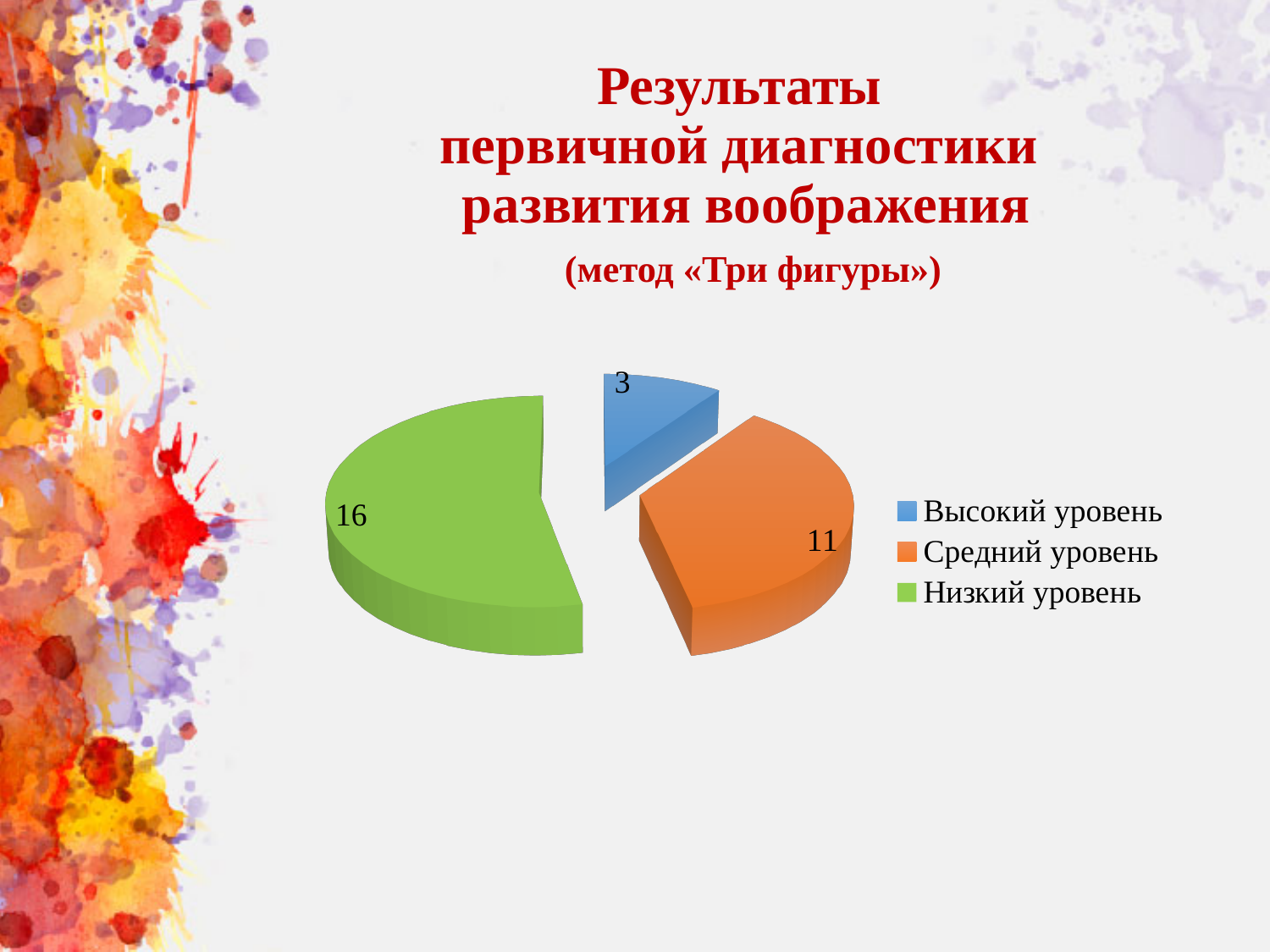
Which level has the largest slice of the pie? Низкий уровень Which is larger, the value for Средний уровень or the value for Высокий уровень? Средний уровень What kind of chart is shown on the slide? pie chart What value is shown for Средний уровень? 11 How many entries does the legend list? 3 What colour is the slice for Низкий уровень? green How many slices does the pie chart have? 3 What value is shown for Низкий уровень? 16 What is the difference between the values for Средний уровень and Высокий уровень? 8 Which level has the smallest slice of the pie? Высокий уровень What is the difference between the values for Низкий уровень and Средний уровень? 5 What value is shown for Высокий уровень? 3